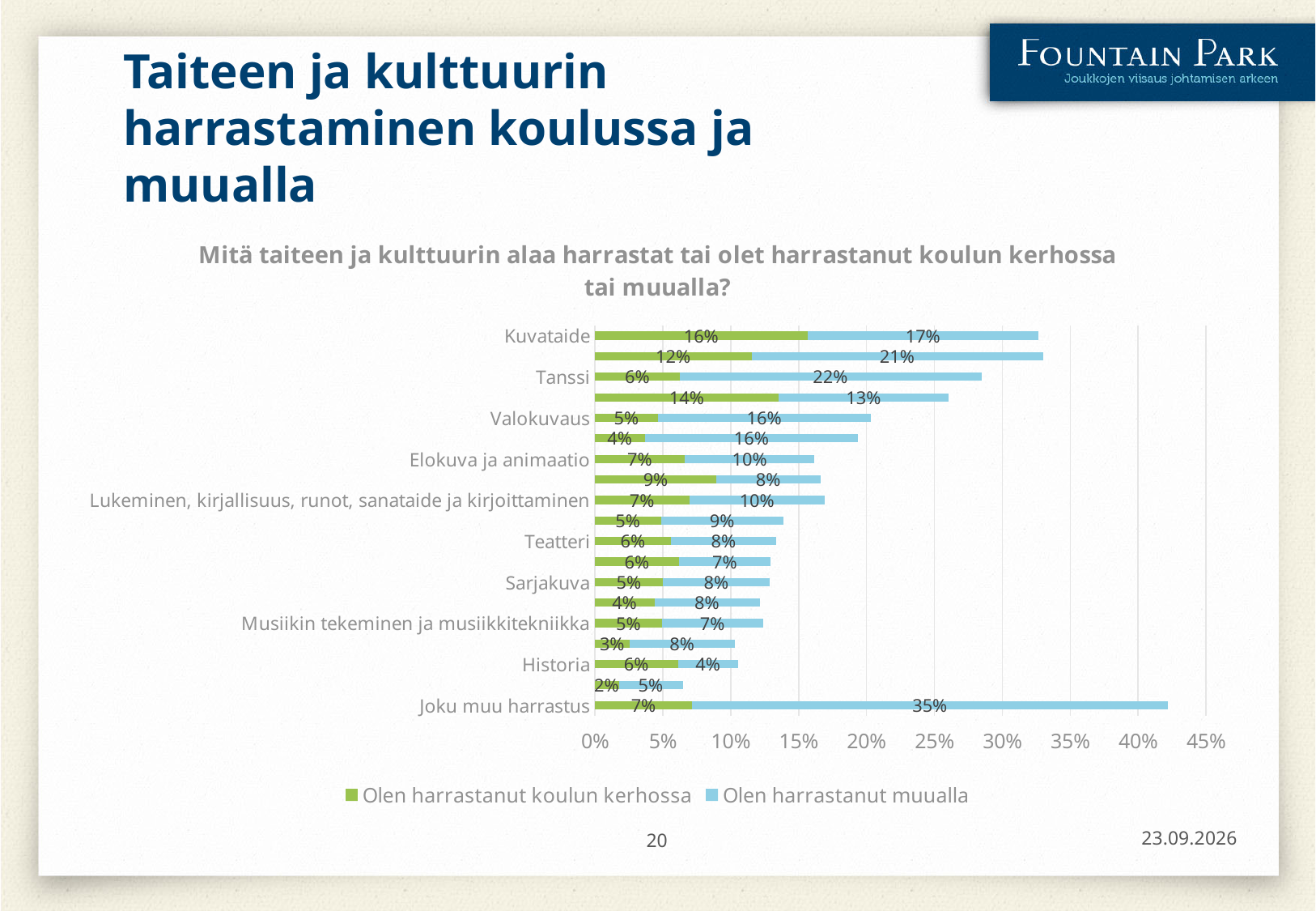
What is the total of the stacked bar for Historia? 10% Which labeled category has the highest value in the series 'Olen harrastanut muualla'? Joku muu harrastus Which colour represents the series 'Olen harrastanut muualla'? Light blue What is the value for Tanssi in the series 'Olen harrastanut muualla'? 22% How many series does the legend list? 2 What is the difference between the 'Olen harrastanut muualla' value and the 'Olen harrastanut koulun kerhossa' value for Tanssi? 16% For Historia, which series has the larger value: 'Olen harrastanut koulun kerhossa' or 'Olen harrastanut muualla'? Olen harrastanut koulun kerhossa What is the value for Joku muu harrastus in the series 'Olen harrastanut muualla'? 35% Is the total of the stacked bar for Joku muu harrastus greater or less than 40%? greater What is the value for Kuvataide in the series 'Olen harrastanut koulun kerhossa'? 16% What is the total of the stacked bar for Kuvataide? 33% What kind of chart is shown on the slide? Stacked bar chart